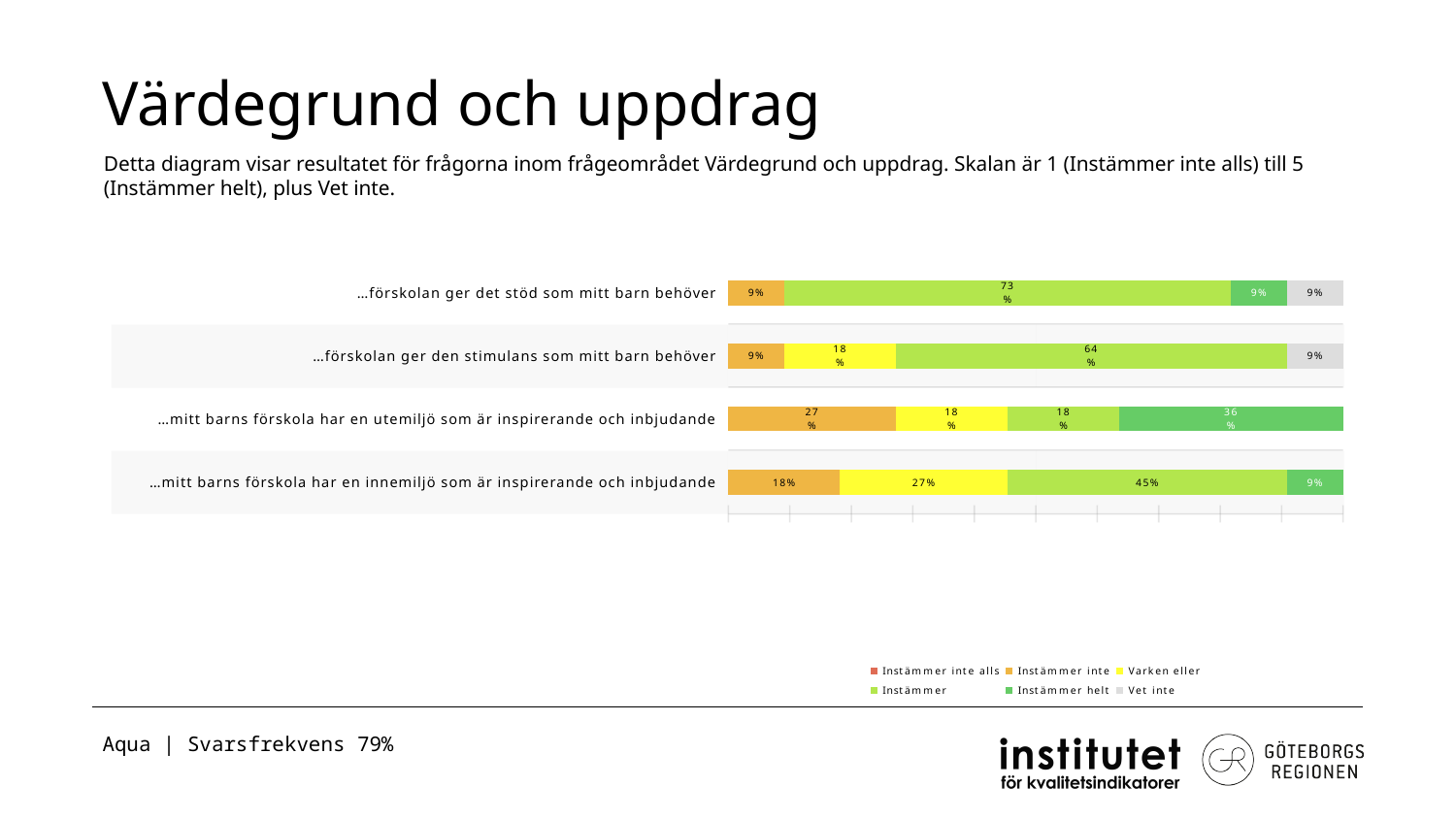
Which legend entry is shown in grey? Vet inte What is the 'Varken eller' value for '…mitt barns förskola har en innemiljö som är inspirerande och inbjudande'? 27% How many series does the legend list? 6 What is the difference between the 'Instämmer' values for '…förskolan ger det stöd som mitt barn behöver' and '…förskolan ger den stimulans som mitt barn behöver'? 9% What is the 'Instämmer' value for '…förskolan ger det stöd som mitt barn behöver'? 73% Which statement has the highest 'Instämmer inte' value? …mitt barns förskola har en utemiljö som är inspirerande och inbjudande What is the 'Instämmer helt' value for '…mitt barns förskola har en utemiljö som är inspirerande och inbjudande'? 36% What is the total of the stacked bar for '…mitt barns förskola har en utemiljö som är inspirerande och inbjudande'? 99% What is the 'Instämmer' value for '…förskolan ger den stimulans som mitt barn behöver'? 64% Which is larger: the 'Instämmer inte' value for the innemiljö statement or for the utemiljö statement? utemiljö (27%) How many statements (categories) are plotted in the chart? 4 What kind of chart is shown on the slide? Stacked bar chart